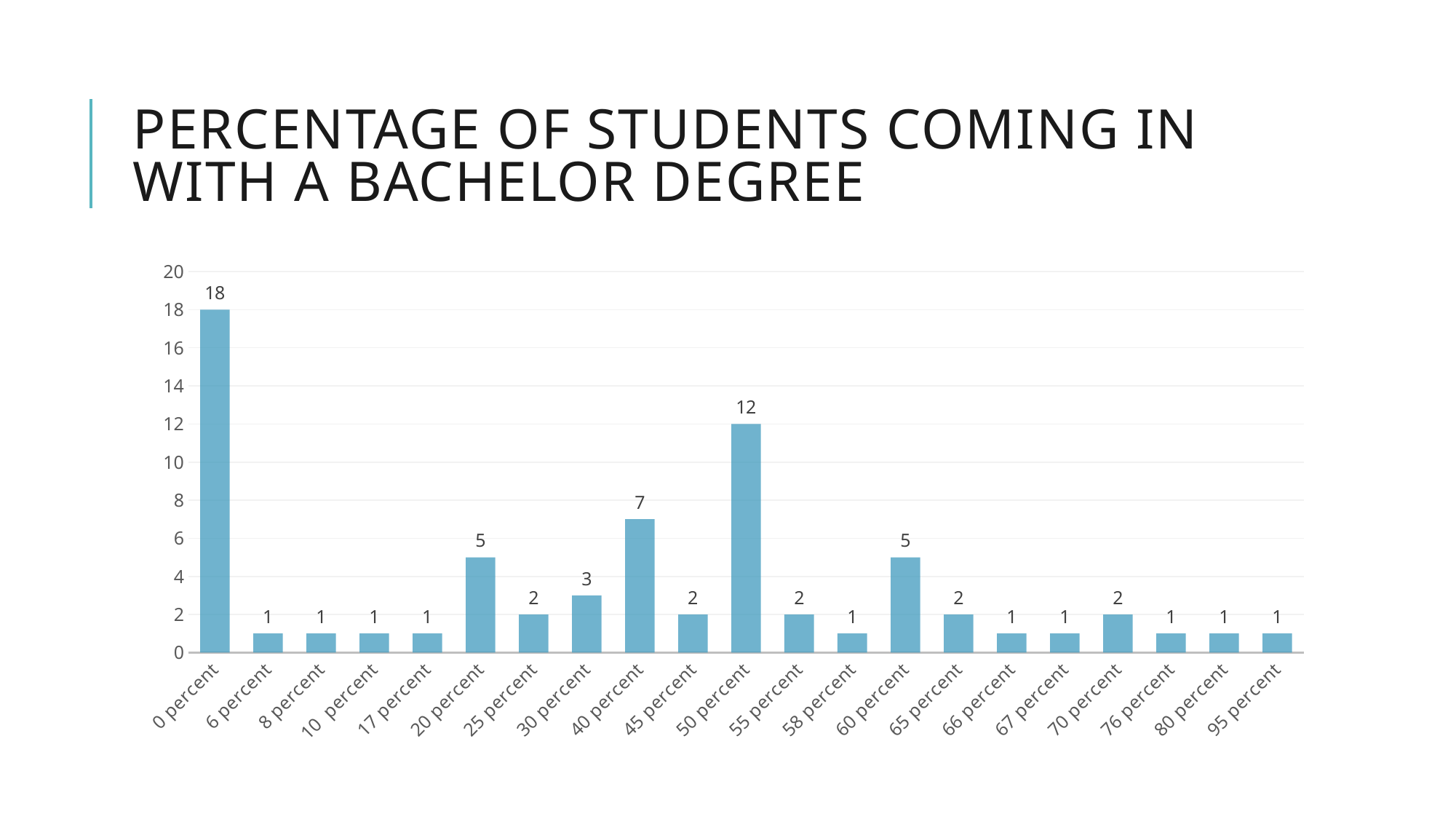
Which category has the highest value? 0 percent How many categories are shown on the x axis? 21 What is the value for the 40 percent category? 7 What is the difference between the values for 0 percent and 50 percent? 6 What is the difference between the values for 40 percent and 20 percent? 2 Which is larger, the value for 60 percent or the value for 70 percent? 60 percent What is the value for the 30 percent category? 3 Is the value for 50 percent greater or less than 10? greater What kind of chart is shown on the slide? bar chart What is the title of the chart? Percentage of Students Coming In With a Bachelor Degree What is the value for the 50 percent category? 12 What is the value for the 0 percent category? 18